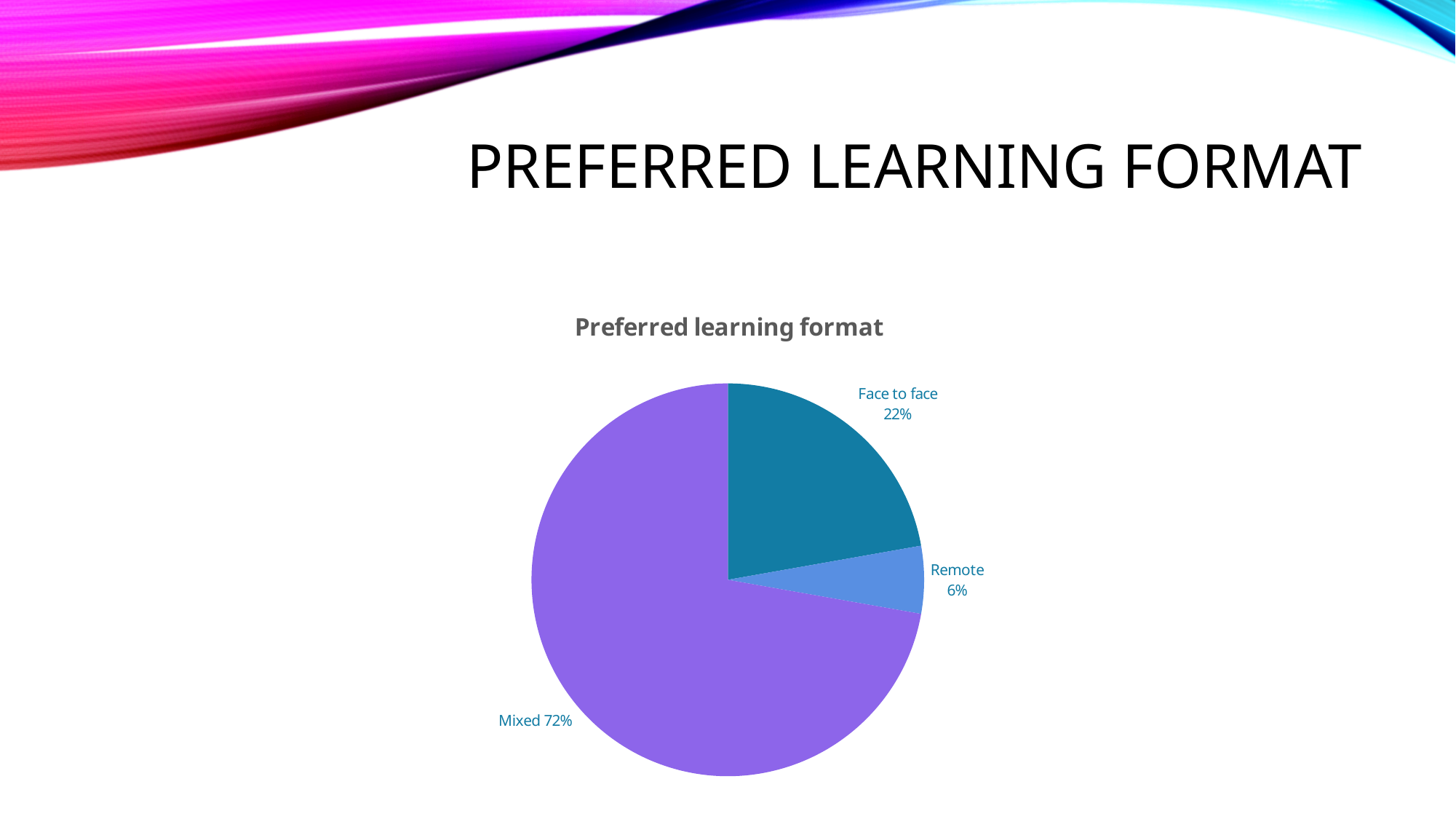
What colour is the Mixed slice? Purple What share of the pie is Face to face? 22% Which is larger, the share for Face to face or the share for Remote? Face to face What is the difference in percentage points between Mixed and Face to face? 50 What type of chart is shown on the slide? Pie chart Which learning format has the smallest share? Remote What is the title of the chart? Preferred learning format What is the difference in percentage points between Face to face and Remote? 16 What share of the pie is Remote? 6% How many slices does the pie chart have? 3 Which learning format has the largest share? Mixed What share of the pie is Mixed? 72%